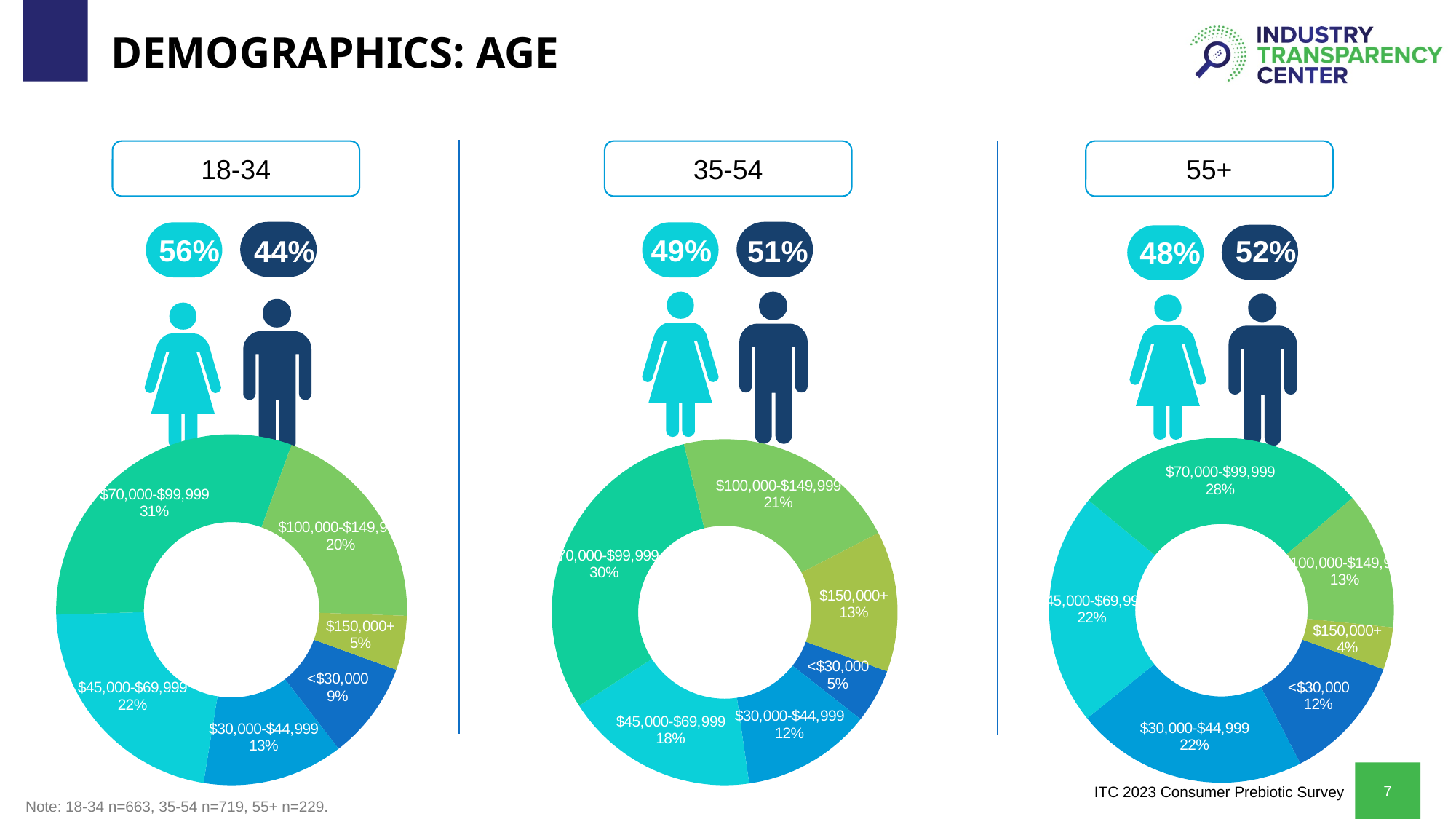
What is the title of the slide? DEMOGRAPHICS: AGE In the 18-34 donut chart, what is the difference between the shares for $45,000-$69,999 and $30,000-$44,999? 9% In the 55+ donut chart, what share is labelled for <$30,000? 12% In the 18-34 donut chart, what share is labelled for $70,000-$99,999? 31% In the 35-54 donut chart, which income bracket has the smallest share? <$30,000 In the 35-54 donut chart, which is larger: the share for $45,000-$69,999 or the share for $100,000-$149,999? $100,000-$149,999 What kind of chart is used to show the income distribution for each age group? Donut (pie) chart How many income brackets are shown in the 55+ donut chart? 6 In the 18-34 donut chart, which income bracket has the largest share? $70,000-$99,999 What is the difference between the $150,000+ share in the 35-54 chart and the $150,000+ share in the 18-34 chart? 8% In the 35-54 donut chart, what share is labelled for $150,000+? 13% In the 55+ donut chart, which income bracket has the smallest share? $150,000+